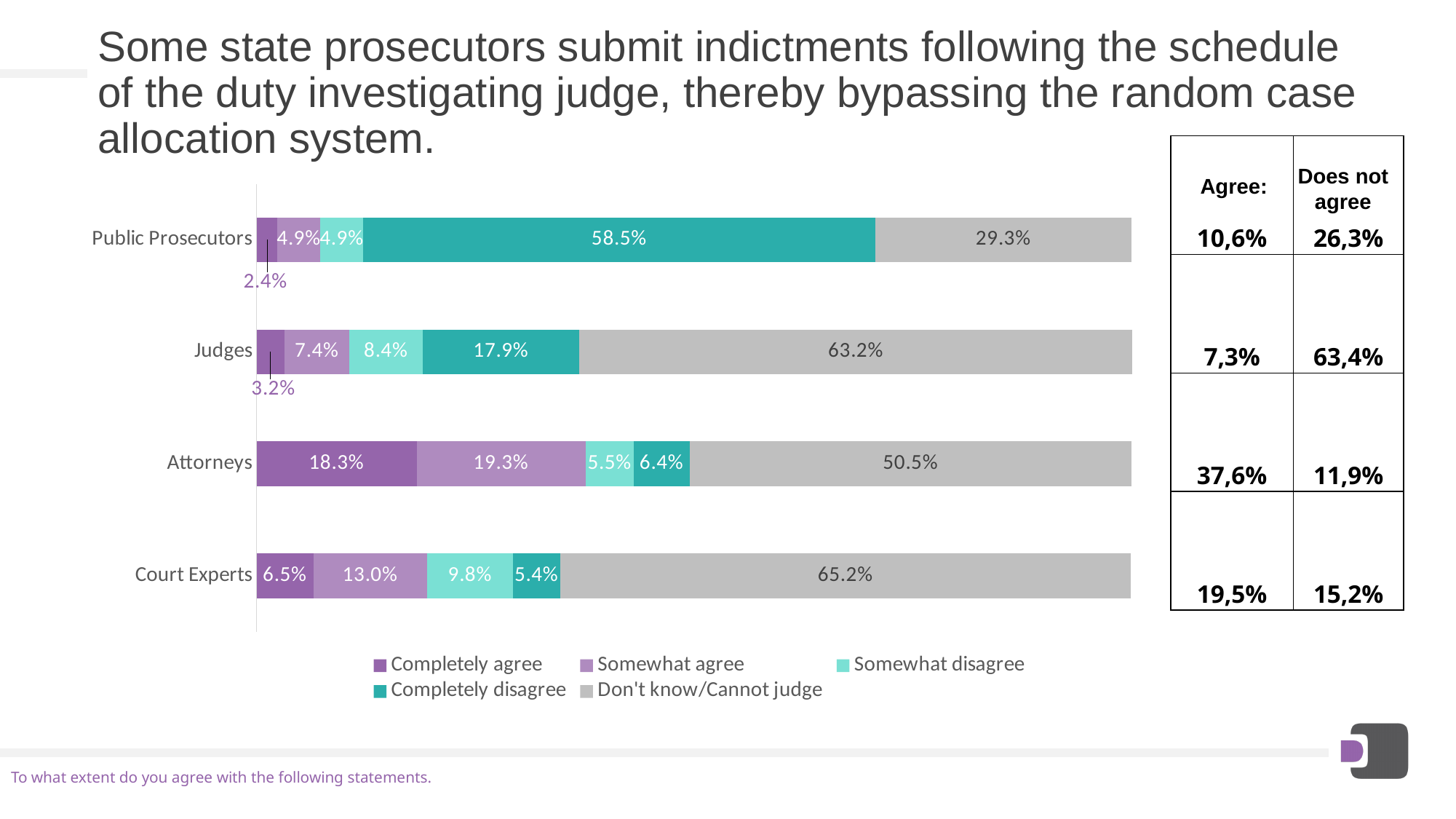
What is the "Don't know/Cannot judge" value for Judges? 63.2% Which is larger: the "Somewhat disagree" value for Court Experts or for Judges? Court Experts What is the "Completely agree" value for Court Experts? 6.5% Which group has the highest "Completely disagree" value? Public Prosecutors What is the difference between the "Somewhat agree" and "Completely agree" values for Attorneys? 1.0 percentage points What percentage of Attorneys answered "Somewhat agree"? 19.3% What type of chart is shown on the slide? Stacked bar chart What is the total of the stacked bar for Attorneys? 100.0% What percentage of Public Prosecutors answered "Completely disagree"? 58.5% How many groups (categories) are shown in the chart? 4 How many series does the legend list? 5 Which group has the lowest "Don't know/Cannot judge" value? Public Prosecutors